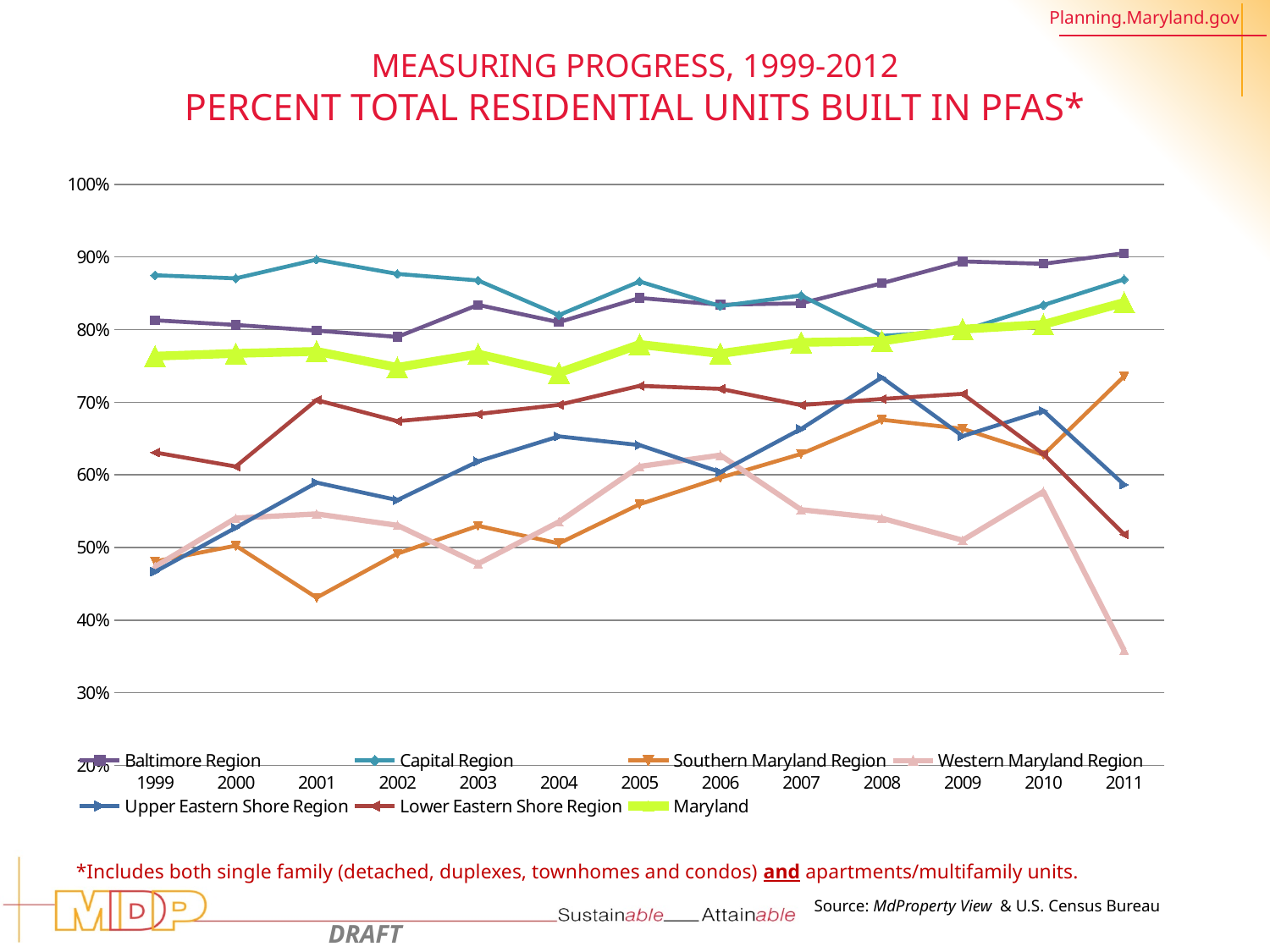
How many series does the legend list? 7 How many years are plotted along the x axis? 13 Is the value for Southern Maryland Region in 2001 greater or less than 50%? less Does the Baltimore Region line rise or fall overall from 1999 to 2011? rise Which region has the highest value in 2011? Baltimore Region Which region has the lowest value in 2011? Western Maryland Region What is the title of the chart? MEASURING PROGRESS, 1999-2012 PERCENT TOTAL RESIDENTIAL UNITS BUILT IN PFAS* What kind of chart is shown on the slide? line chart Is the value for Maryland in 2011 greater or less than 80%? greater Is the value for Western Maryland Region in 2011 greater or less than 40%? less In 1999, which is larger: the Capital Region value or the Baltimore Region value? Capital Region Which series has the highest value in 1999? Capital Region